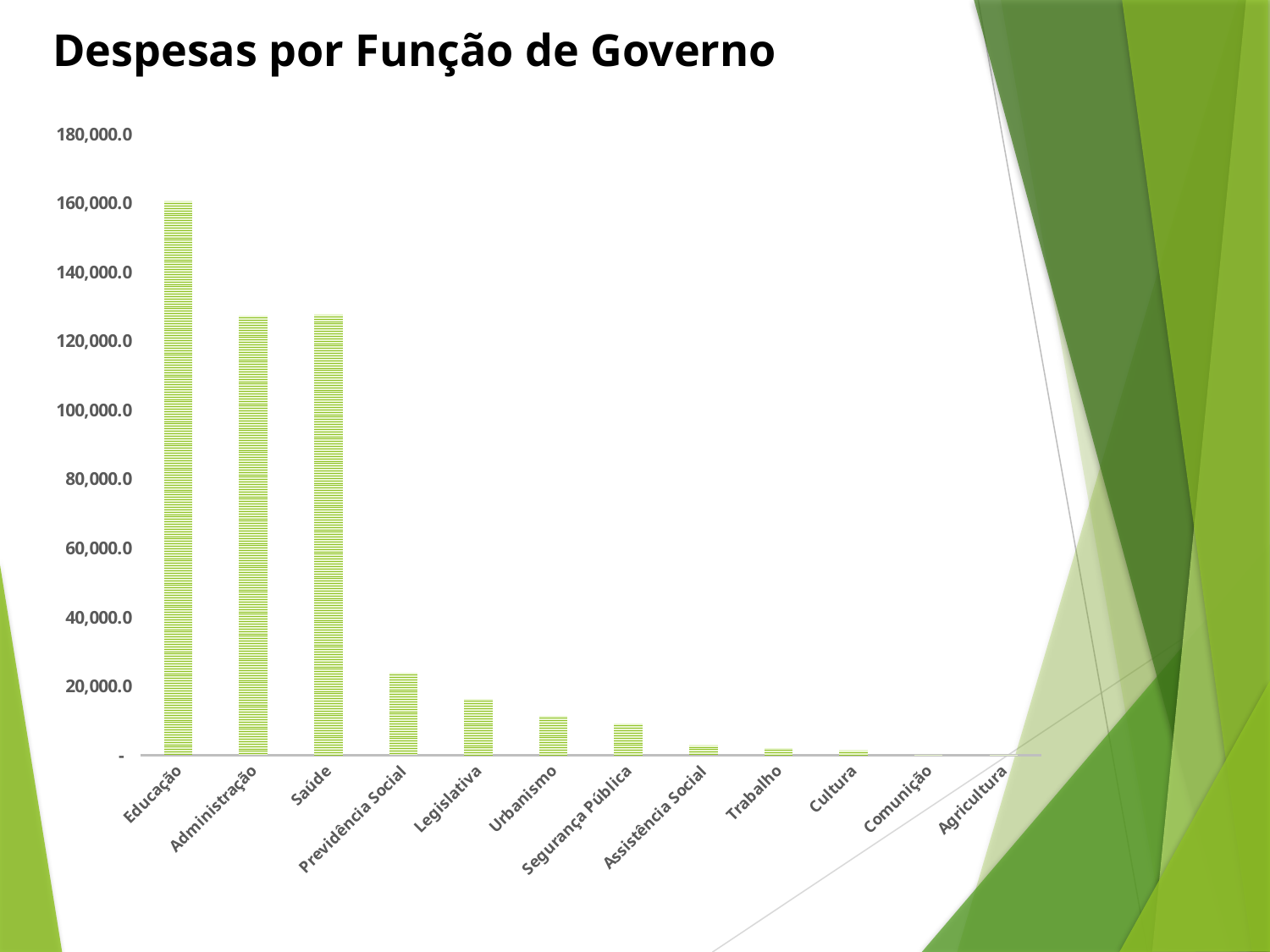
Which is larger, the value for Educação or the value for Administração? Educação Which category has the highest value in the chart? Educação What kind of chart is shown on the slide? bar chart Do the values generally rise or fall moving from left to right along the x axis? fall Which is larger, the value for Previdência Social or the value for Legislativa? Previdência Social How many categories are shown on the x axis of the chart? 12 Is the value for Legislativa greater or less than 20,000.0? less Is the value for Previdência Social greater or less than 20,000.0? greater Is the value for Administração greater or less than 120,000.0? greater What is the title of the chart? Despesas por Função de Governo